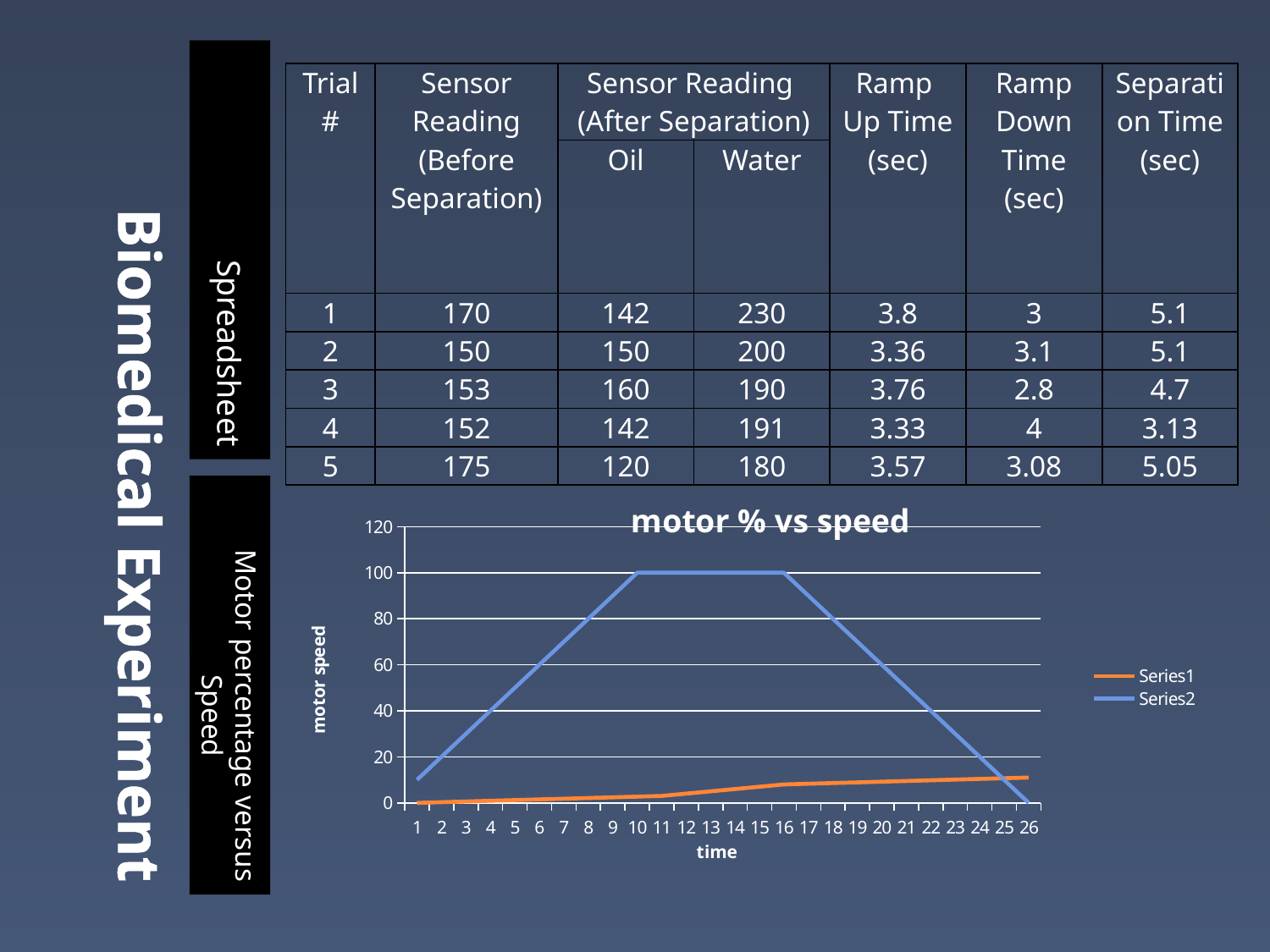
Does Series2 rise or fall between time 16 and time 26? fall Which series reaches the highest value on the chart? Series2 How many time points are shown along the x axis of the chart? 26 At time 13, which series has the larger value, Series1 or Series2? Series2 How many series does the chart legend list? 2 Is the value of Series1 at time 20 greater or less than 20? less Is the value of Series2 at time 20 greater or less than 40? greater What is the label of the y axis of the chart? motor speed What is the title of the chart? motor % vs speed What kind of chart is shown on the slide? line chart Is the value of Series2 at time 13 greater or less than 80? greater